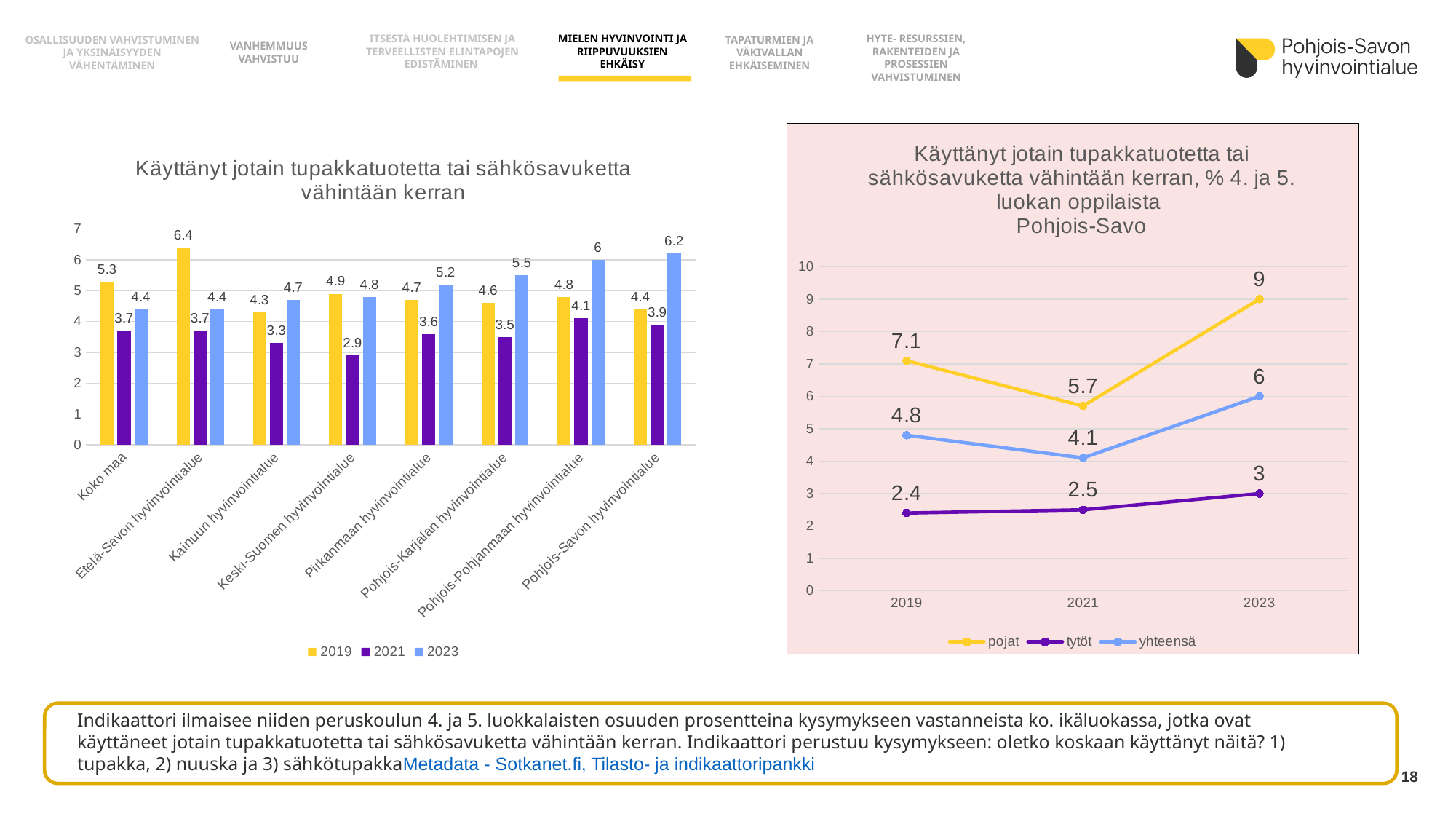
In the left bar chart, which category has the highest 2023 value? Pohjois-Savon hyvinvointialue In the right line chart, what is the value for pojat in 2023? 9 In the left bar chart, what is the 2019 value for Etelä-Savon hyvinvointialue? 6.4 What kind of chart is the chart on the right side of the slide? Line chart In the left bar chart, what is the difference between the 2023 and 2021 values for Pohjois-Pohjanmaan hyvinvointialue? 1.9 In the left bar chart, how many series does the legend list? 3 In the right line chart, what is the value for yhteensä in 2021? 4.1 In the left bar chart, which category has the lowest 2021 value? Keski-Suomen hyvinvointialue In the right line chart, what is the difference between pojat and tytöt in 2023? 6 In the left bar chart, what is the 2023 value for Pohjois-Savon hyvinvointialue? 6.2 In the right line chart, which is larger in 2019: pojat or tytöt? pojat In the left bar chart, how many categories are shown on the x axis? 8